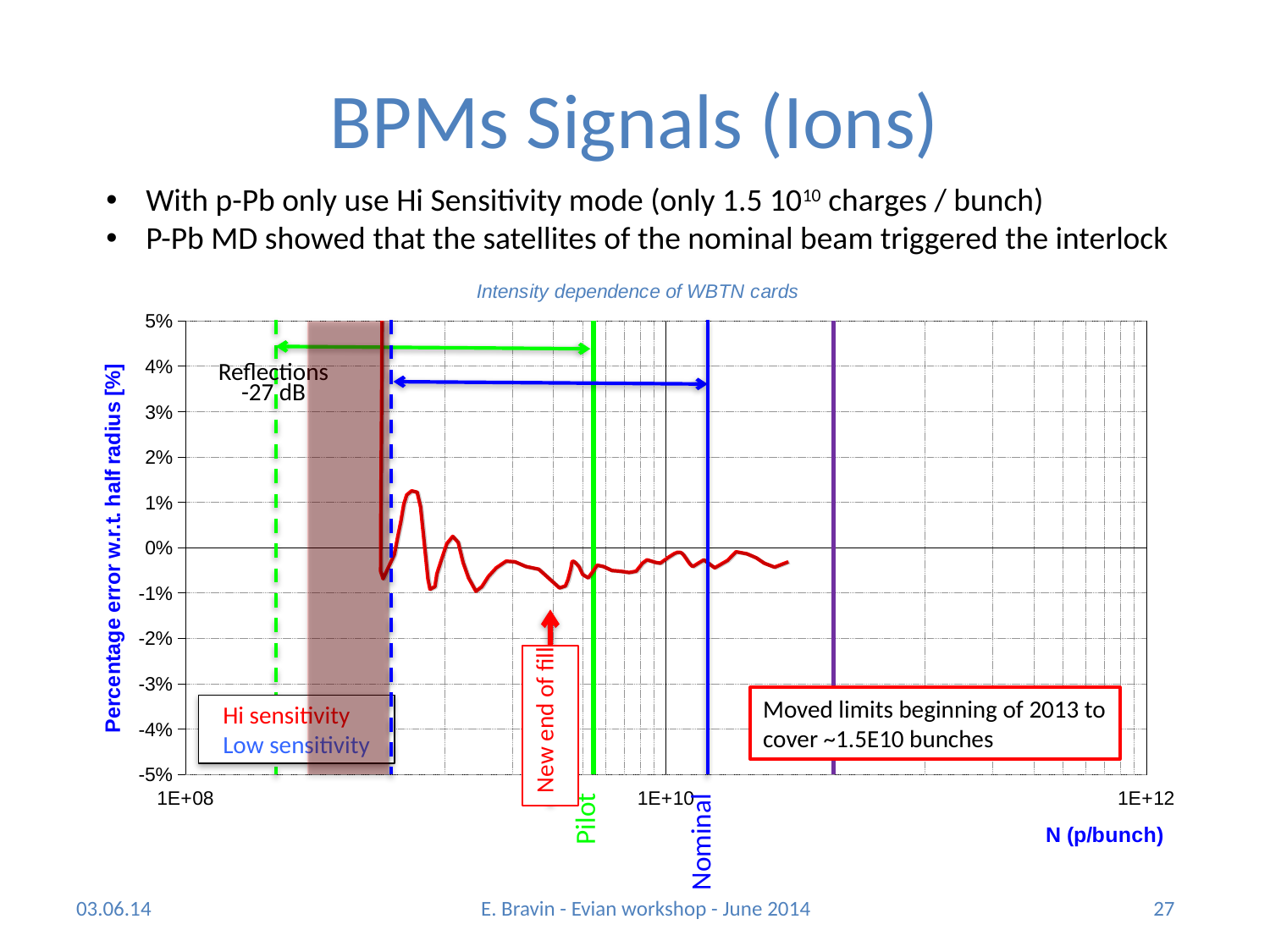
What is the label of the chart's y-axis? Percentage error w.r.t. half radius [%] What reflection level in dB is annotated on the chart? -27 dB What kind of chart is shown on the slide? Line chart What is the largest tick value shown on the chart's x-axis (N (p/bunch))? 1E+12 Is the lowest point of the plotted red curve greater or less than -2%? greater What is the title of the chart? Intensity dependence of WBTN cards Is the plotted percentage error at N = 1E+10 p/bunch greater or less than 0%? less What is the smallest tick value shown on the chart's x-axis (N (p/bunch))? 1E+08 What is the highest value shown on the chart's y-axis? 5% What is the lowest value shown on the chart's y-axis? -5% According to the annotation box on the chart, the limits were moved at the beginning of 2013 to cover bunches of roughly what intensity? ~1.5E10